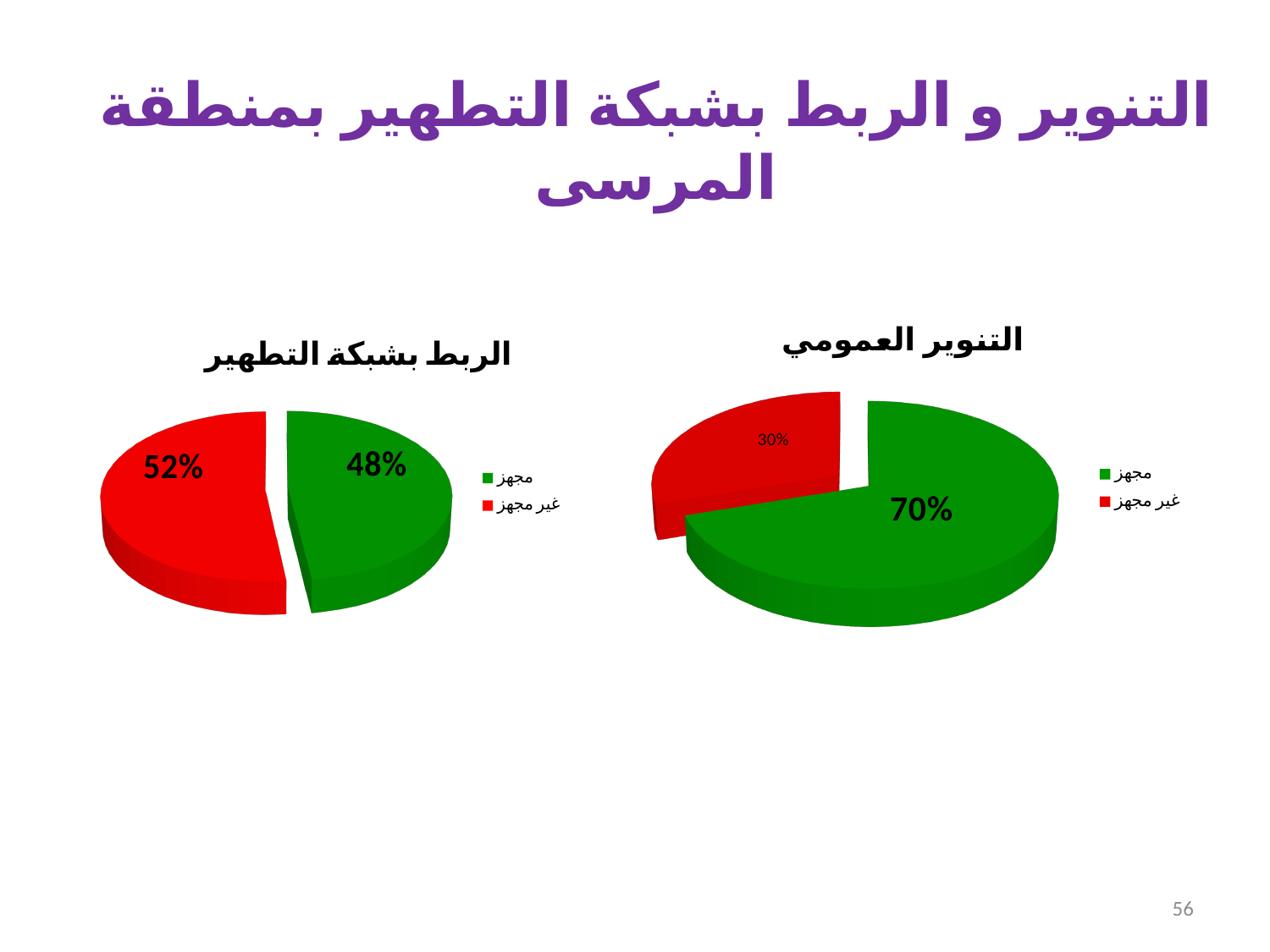
In the pie chart titled "الربط بشبكة التطهير" (left), what share is labelled "غير مجهز"? 52% In the pie chart titled "التنوير العمومي" (right), what is the difference in percentage points between "مجهز" and "غير مجهز"? 40 In the pie chart titled "التنوير العمومي" (right), what share is labelled "غير مجهز"? 30% In the pie chart titled "التنوير العمومي" (right), what share is labelled "مجهز"? 70% How many entries does the legend of the pie chart titled "التنوير العمومي" (right) list? 2 In the pie chart titled "الربط بشبكة التطهير" (left), which category has the smallest slice? مجهز In the pie chart titled "الربط بشبكة التطهير" (left), what colour is the slice labelled "غير مجهز"? Red In the pie chart titled "التنوير العمومي" (right), which category has the largest slice? مجهز How many slices does the pie chart titled "الربط بشبكة التطهير" (left) have? 2 In the pie chart titled "الربط بشبكة التطهير" (left), what share is labelled "مجهز"? 48% In the pie chart titled "الربط بشبكة التطهير" (left), which is larger: "مجهز" or "غير مجهز"? غير مجهز What type of chart is used for "التنوير العمومي" on the right of the slide? Pie chart